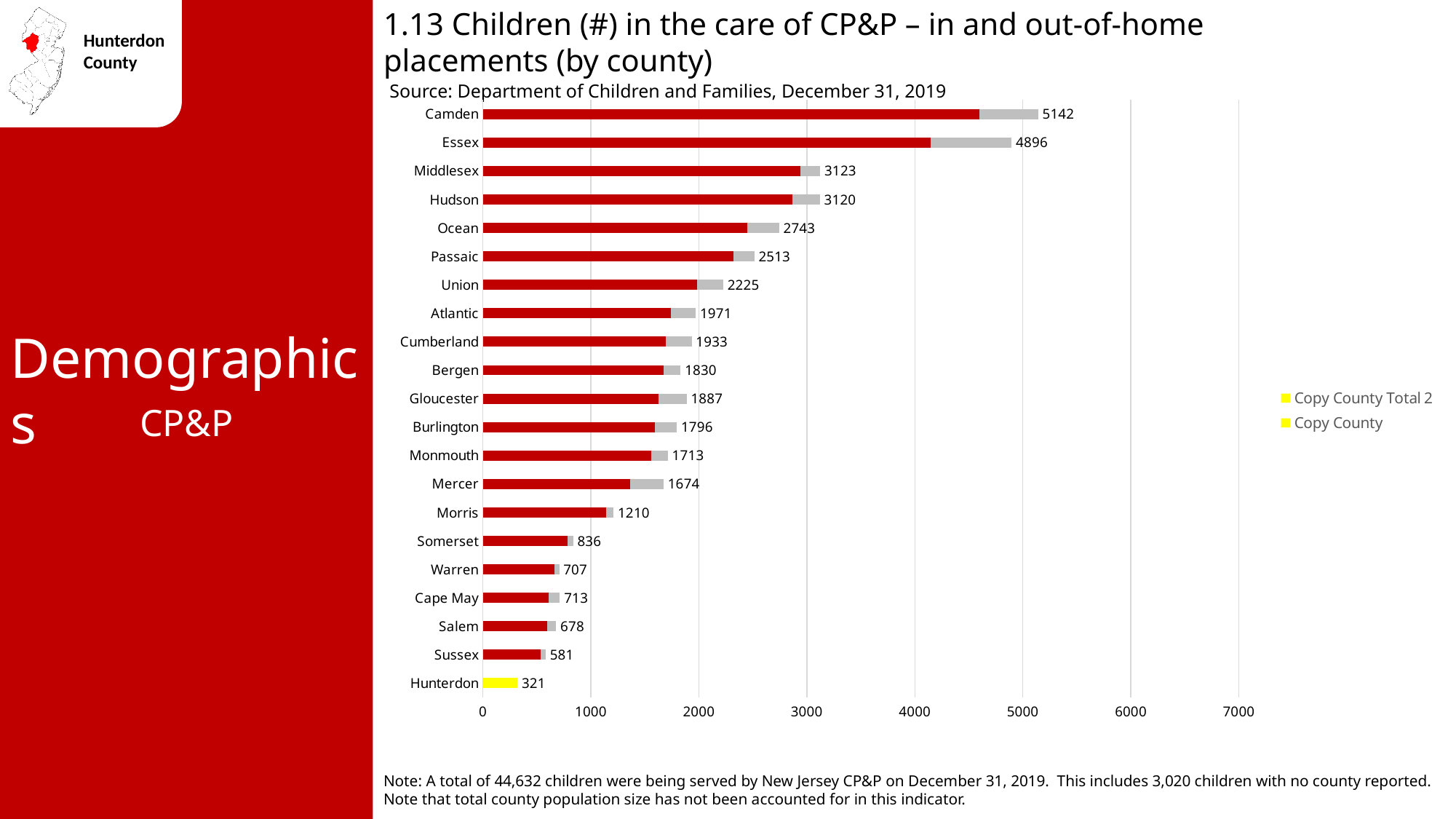
What is the total number of children in the care of CP&P for Camden? 5142 Which county has the highest number of children in the care of CP&P? Camden What is the difference between the values for Sussex and Hunterdon? 260 What is the difference between the values for Camden and Essex? 246 What is the value shown for Hunterdon? 321 Which county has the lowest number of children in the care of CP&P? Hunterdon What is the value shown for Morris? 1210 Is the value for Ocean greater or less than 2000? greater How many counties are shown in the chart? 21 Which county's bar is highlighted in yellow? Hunterdon Which has a larger value, Bergen or Gloucester? Gloucester What kind of chart is shown on the slide? Bar chart